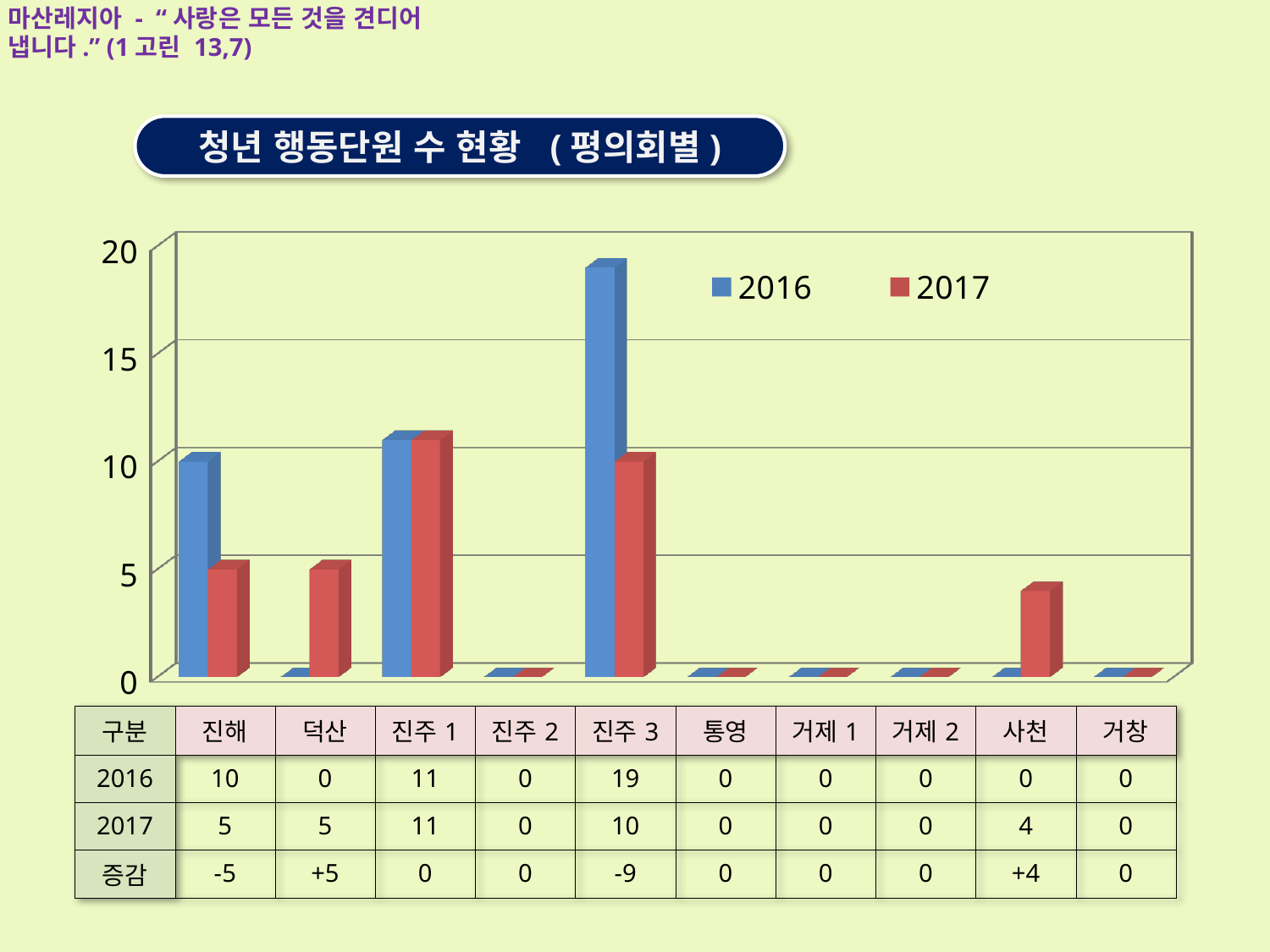
What type of chart is shown on the slide? bar chart How many categories are shown on the x axis of the chart? 10 What is the difference between the 2016 and 2017 values for 진주 3? 9 What is the 2016 value for 진주 3? 19 What is the title of the chart? 청년 행동단원 수 현황 (평의회별) What is the 2017 value for 진해? 5 How many series does the legend list? 2 Is the 2016 value for 진주 3 greater or less than 15? greater Which category has the highest 2017 value? 진주 1 What is the 2017 value for 사천? 4 Which category has the highest 2016 value? 진주 3 Which is larger for 진해, the 2016 value or the 2017 value? 2016